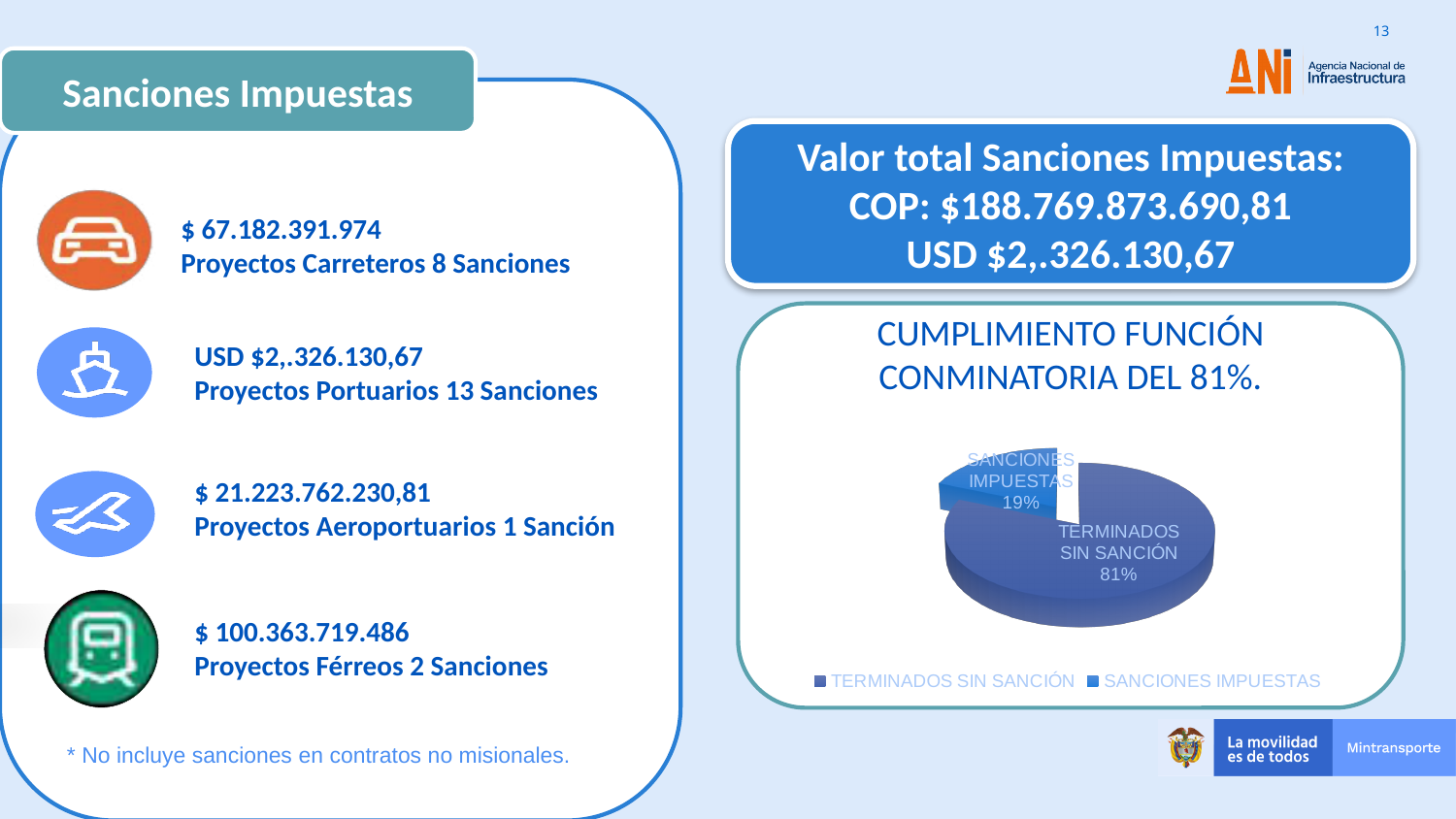
Which slice of the pie chart is the largest? TERMINADOS SIN SANCIÓN What share of the pie does SANCIONES IMPUESTAS represent? 19% Which slice of the pie chart is the smallest? SANCIONES IMPUESTAS Which legend entry is listed first below the pie chart? TERMINADOS SIN SANCIÓN How many slices does the pie chart have? 2 What is the total of the two percentages shown on the pie chart? 100% How many entries does the legend of the pie chart list? 2 What share of the pie does TERMINADOS SIN SANCIÓN represent? 81% What kind of chart is shown on the slide? pie chart What is the difference in percentage points between the TERMINADOS SIN SANCIÓN slice and the SANCIONES IMPUESTAS slice? 62 percentage points Which is larger in the pie chart, TERMINADOS SIN SANCIÓN or SANCIONES IMPUESTAS? TERMINADOS SIN SANCIÓN